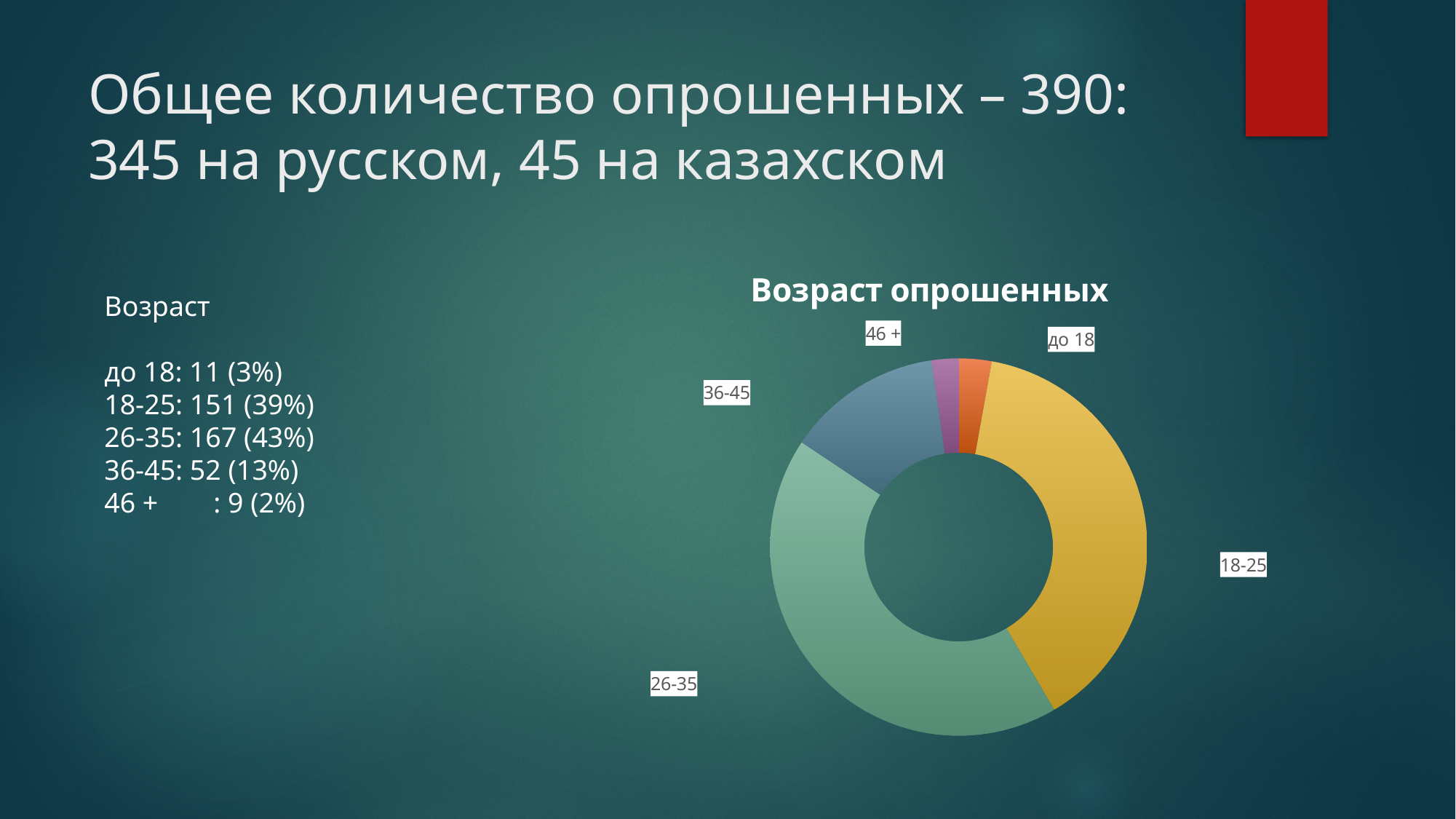
What type of chart is shown on the slide? doughnut (pie) chart What is the difference in respondents between the 26-35 and 18-25 groups? 16 What is the title of the chart? Возраст опрошенных How many age categories does the chart show? 5 What percentage of respondents are in the 36-45 age group? 13% How many respondents are under 18 (до 18)? 11 What percentage of respondents are in the 26-35 age group? 43% How many respondents are in the 18-25 age group? 151 Which age category has the largest slice in the chart? 26-35 Which slice is larger: 18-25 or 36-45? 18-25 Which age category has the smallest slice in the chart? 46 + What colour is the 18-25 slice in the chart? yellow